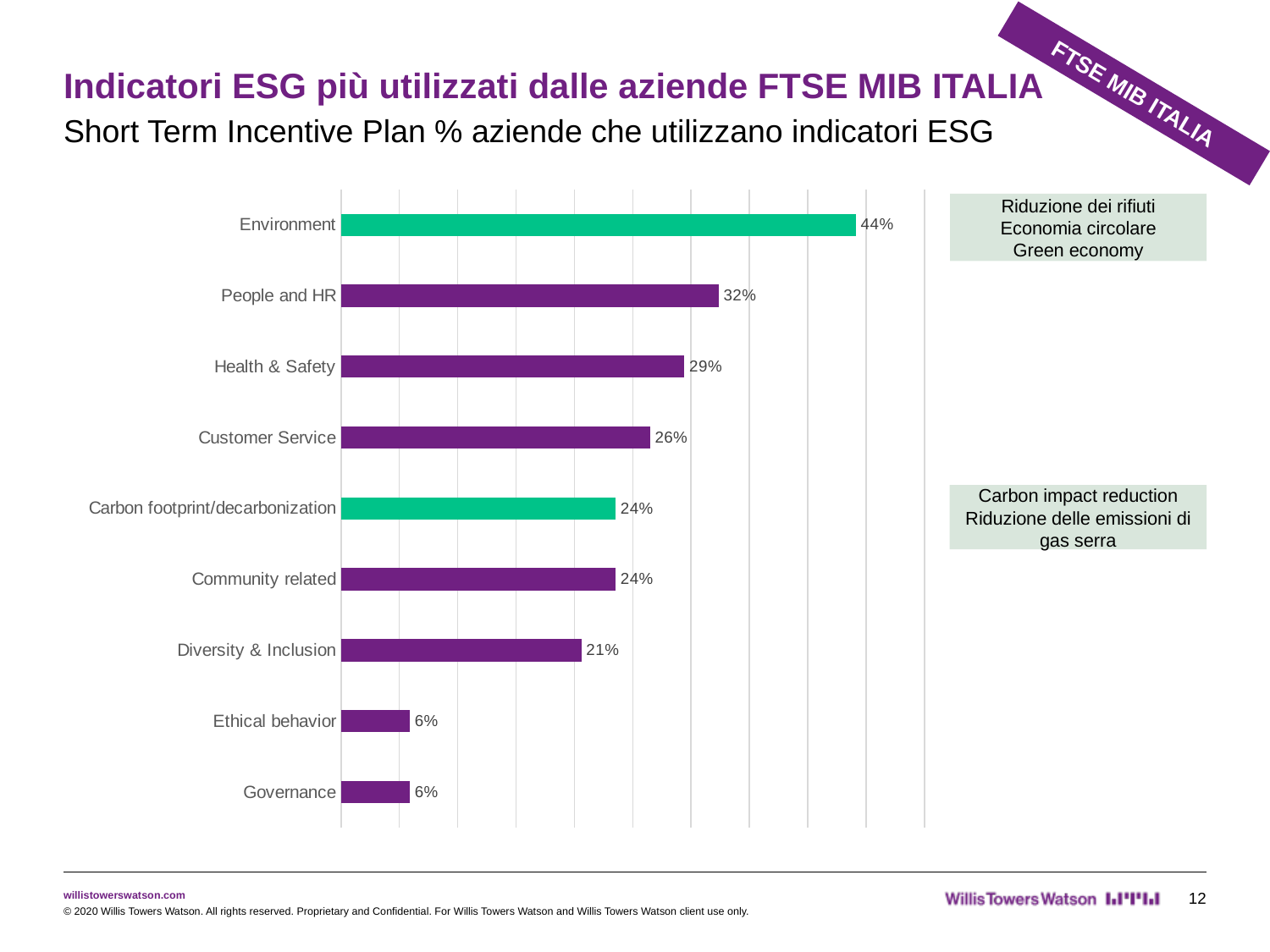
What is the value for Diversity & Inclusion? 21% Which two categories are shown with green bars instead of purple? Environment and Carbon footprint/decarbonization What kind of chart is shown on the slide? Bar chart What is the difference between the values for Environment and People and HR? 12% How many categories are shown in the chart? 9 Which category has the highest value? Environment What is the difference between Health & Safety and Customer Service? 3% Which is larger, the value for Health & Safety or the value for Community related? Health & Safety What is the value for People and HR? 32% What percentage of companies use the Environment indicator? 44% What is the subtitle of the chart on the slide? Short Term Incentive Plan % aziende che utilizzano indicatori ESG What value is shown for Governance? 6%